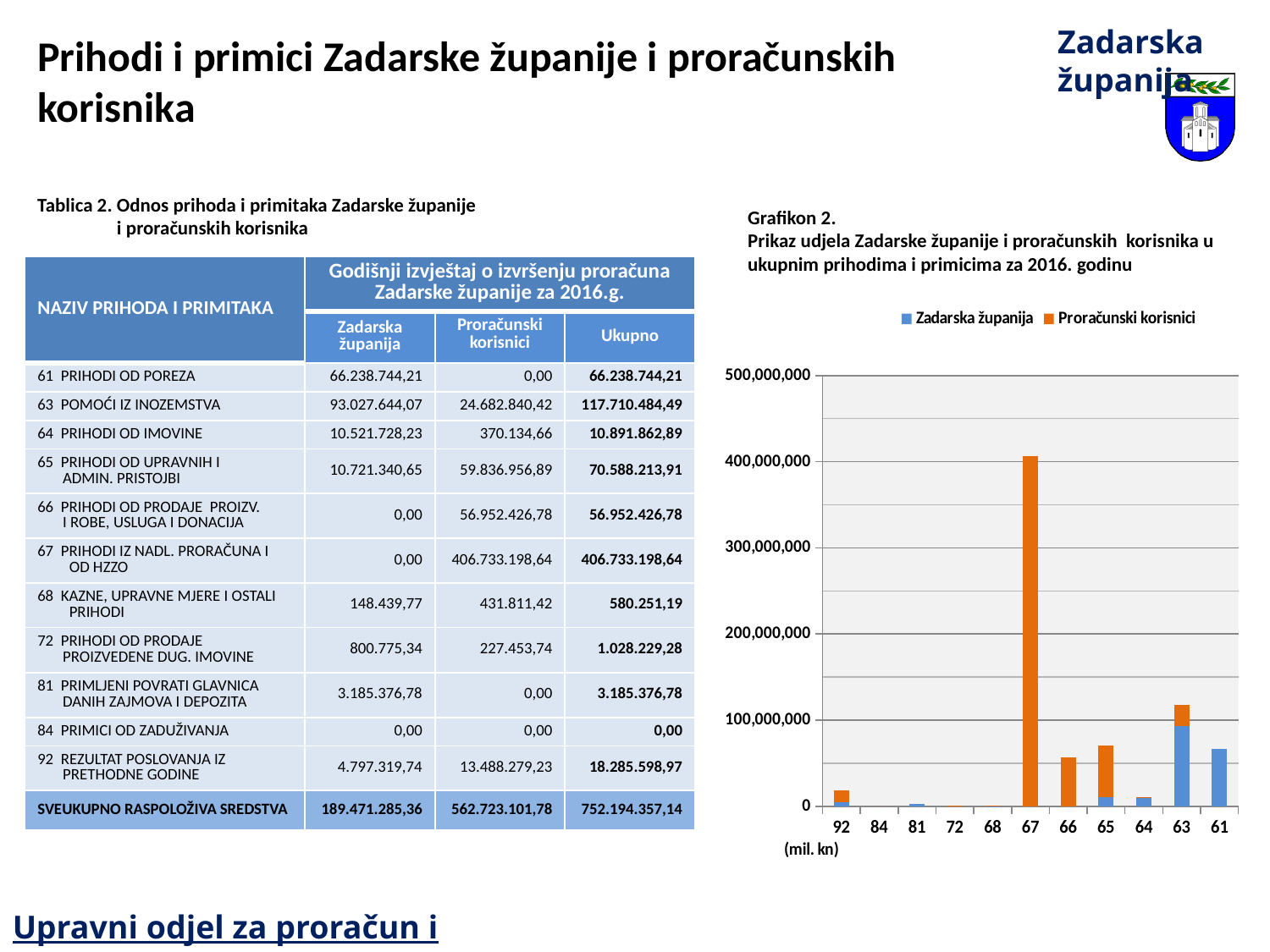
In Grafikon 2, is the value for category 66 greater or less than 100,000,000? less In Grafikon 2, is the total bar for category 63 greater or less than 100,000,000? greater In Grafikon 2, which category has the tallest bar? 67 In Grafikon 2, which bar is taller: category 63 or category 61? 63 In Grafikon 2, which bar is taller: category 67 or category 63? 67 How many series does the legend of Grafikon 2 list? 2 What kind of chart is Grafikon 2? bar chart In Grafikon 2, is the value for category 67 greater or less than 300,000,000? greater What unit label is shown below the x axis of Grafikon 2? (mil. kn) In Grafikon 2, which colour represents the series Zadarska županija? blue How many categories are shown on the x axis of Grafikon 2? 11